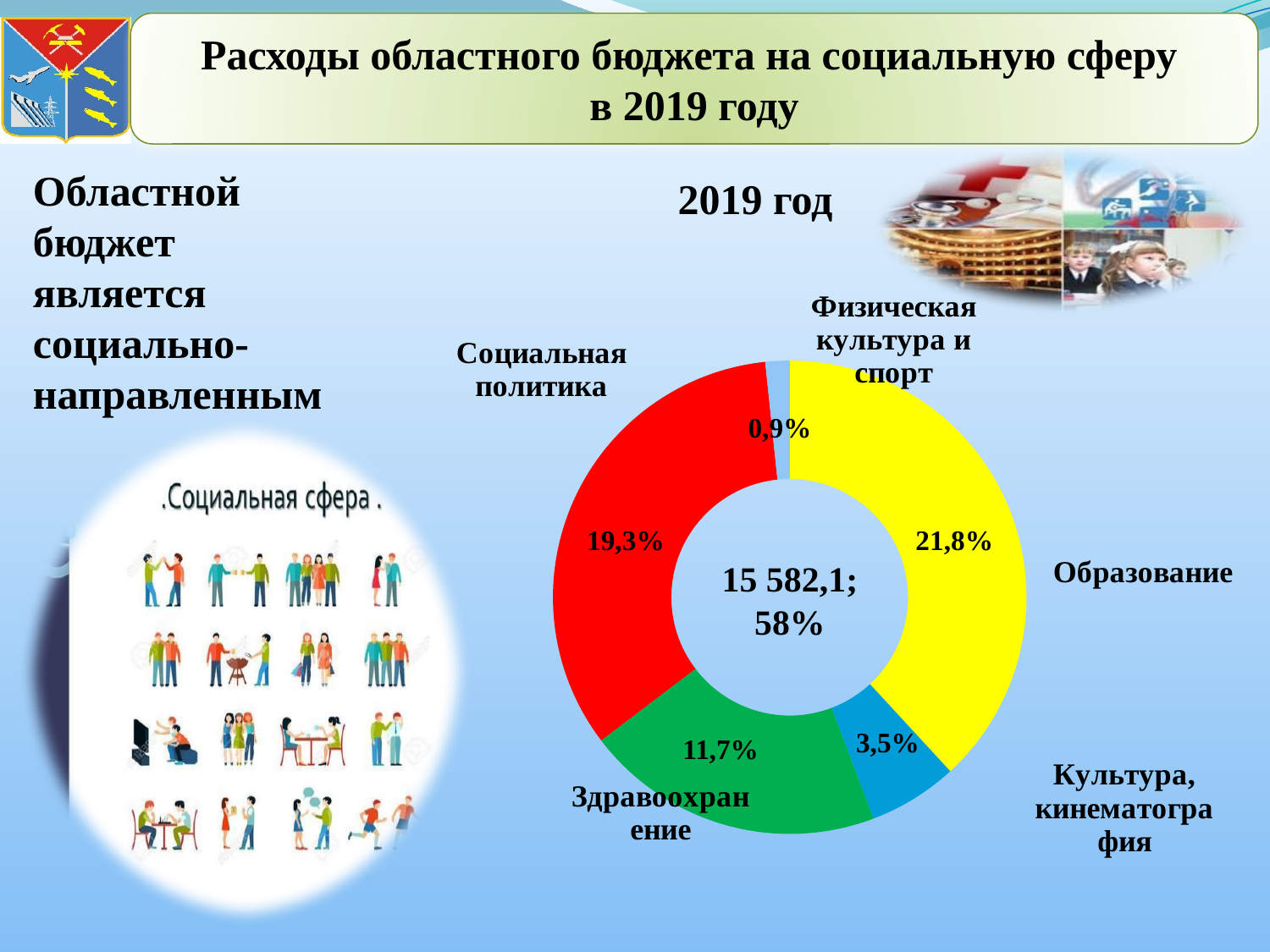
What is the difference in percentage points between Образование and Социальная политика? 2,5 What kind of chart is shown on the slide? Doughnut (pie) chart Which is larger: Здравоохранение or Культура, кинематография? Здравоохранение How many categories are shown in the chart? 5 What value is shown for Социальная политика? 19,3% Which category has the largest share of the chart? Образование What share of the chart does Образование have? 21,8% What text is shown in the centre of the doughnut chart? 15 582,1; 58% What value is shown for Физическая культура и спорт? 0,9% What value is shown for Здравоохранение? 11,7% Which category has the smallest share of the chart? Физическая культура и спорт What value is shown for Культура, кинематография? 3,5%